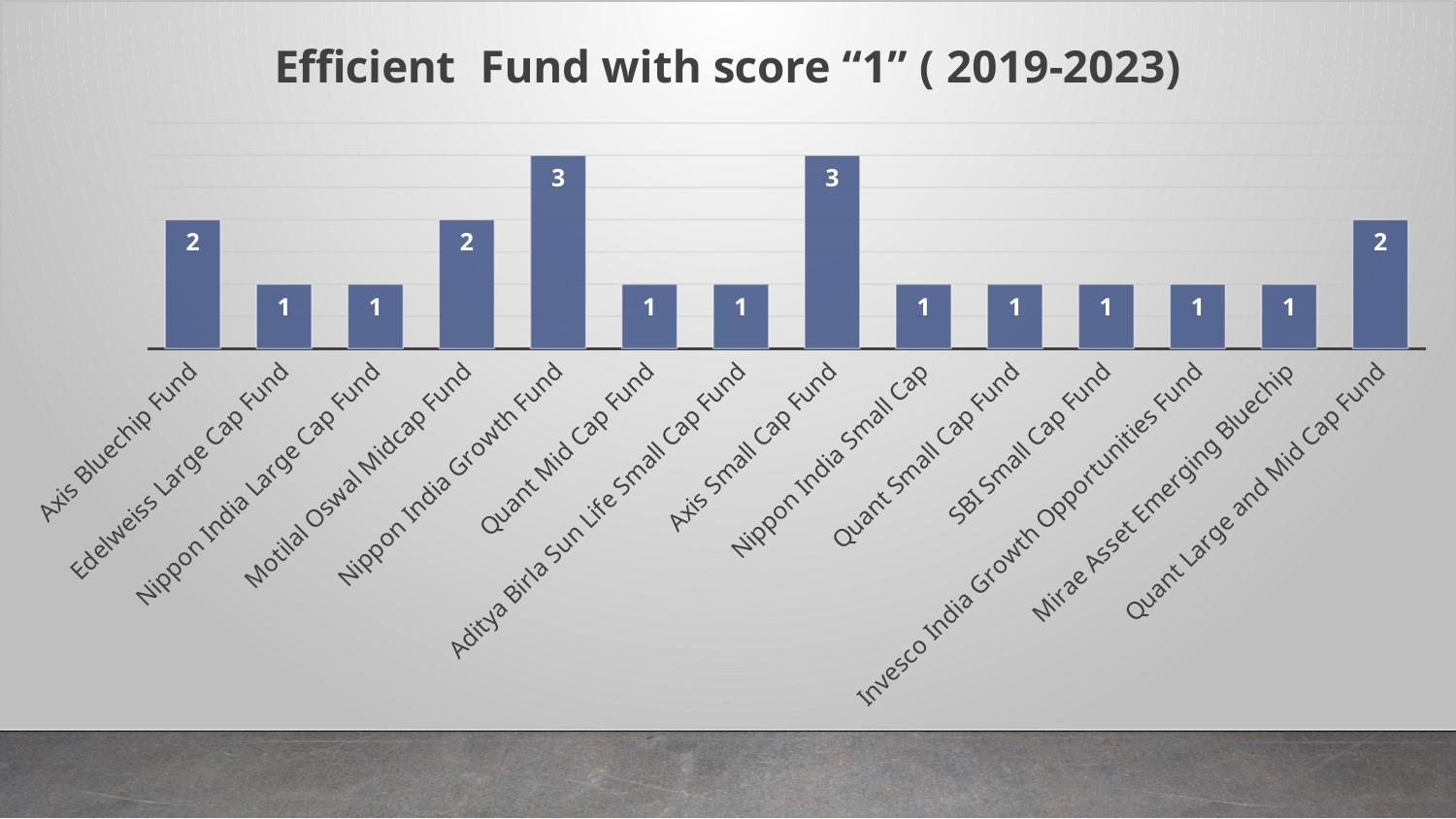
What is the difference between the value for Nippon India Growth Fund and the value for Axis Bluechip Fund? 1 What is the value for Quant Large and Mid Cap Fund? 2 How many funds have a value of 1? 9 How many funds are shown on the chart? 14 What is the title of the chart? Efficient Fund with score "1" ( 2019-2023) What is the value for Nippon India Growth Fund? 3 What type of chart is shown on the slide? Bar chart What is the value for Axis Bluechip Fund? 2 Which two funds have the highest value on the chart? Nippon India Growth Fund and Axis Small Cap Fund What is the value for SBI Small Cap Fund? 1 Which is larger, the value for Motilal Oswal Midcap Fund or the value for Quant Mid Cap Fund? Motilal Oswal Midcap Fund What is the difference between the value for Axis Small Cap Fund and the value for Quant Small Cap Fund? 2